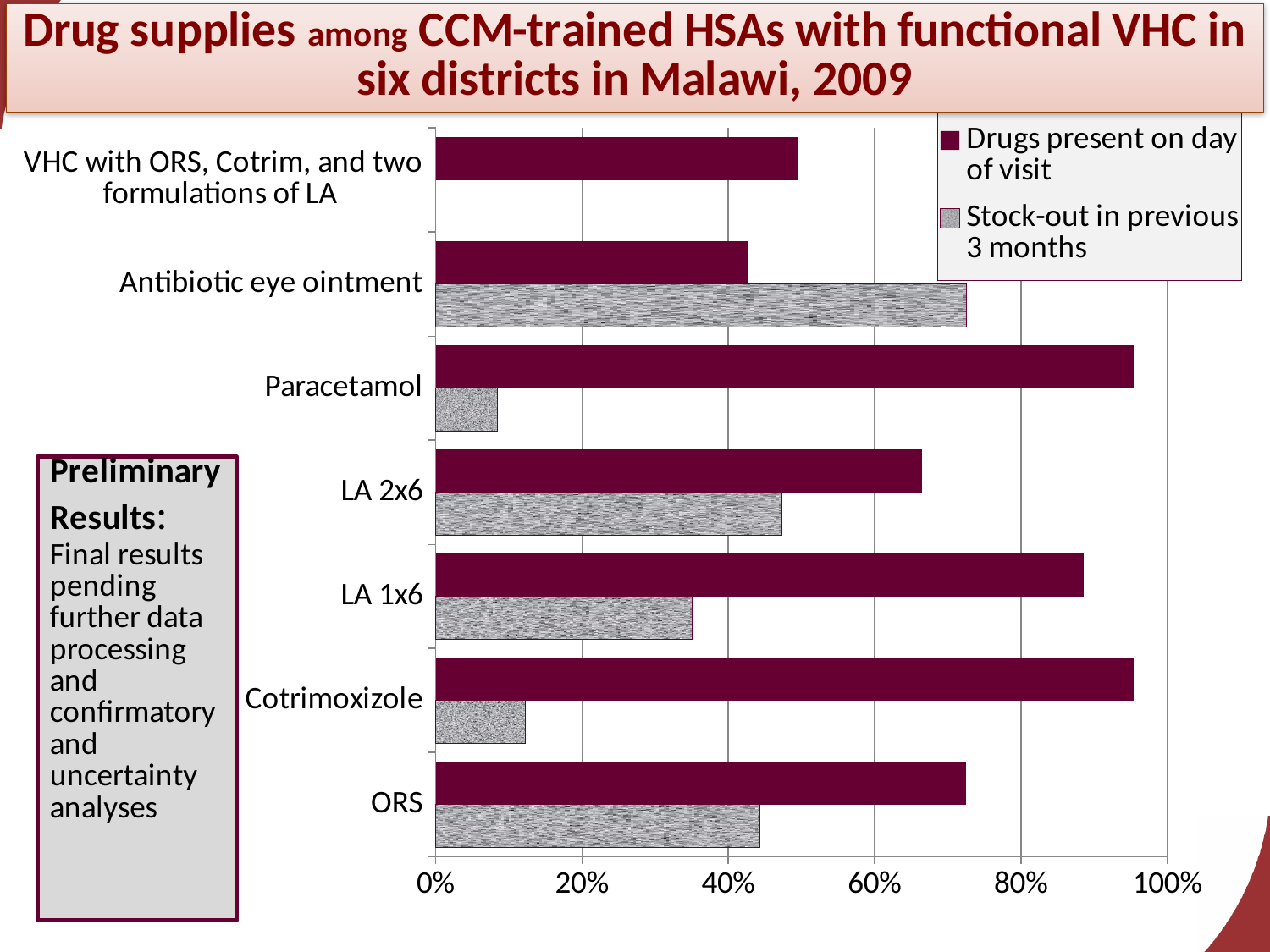
Which series in the legend is shown with the solid dark maroon bars? Drugs present on day of visit How many drug categories are listed on the vertical axis of the chart? 7 Is the 'Stock-out in previous 3 months' value for Antibiotic eye ointment greater or less than 60%? greater For ORS, which is larger: 'Drugs present on day of visit' or 'Stock-out in previous 3 months'? Drugs present on day of visit For Antibiotic eye ointment, which is larger: 'Drugs present on day of visit' or 'Stock-out in previous 3 months'? Stock-out in previous 3 months Which has the larger 'Drugs present on day of visit' value: LA 1x6 or LA 2x6? LA 1x6 Is the 'Drugs present on day of visit' value for Paracetamol greater or less than 80%? greater How many series does the chart legend list? 2 Is the 'Stock-out in previous 3 months' value for Cotrimoxizole greater or less than 20%? less Which drug has the highest value for 'Stock-out in previous 3 months'? Antibiotic eye ointment What kind of chart is shown on the slide? bar chart